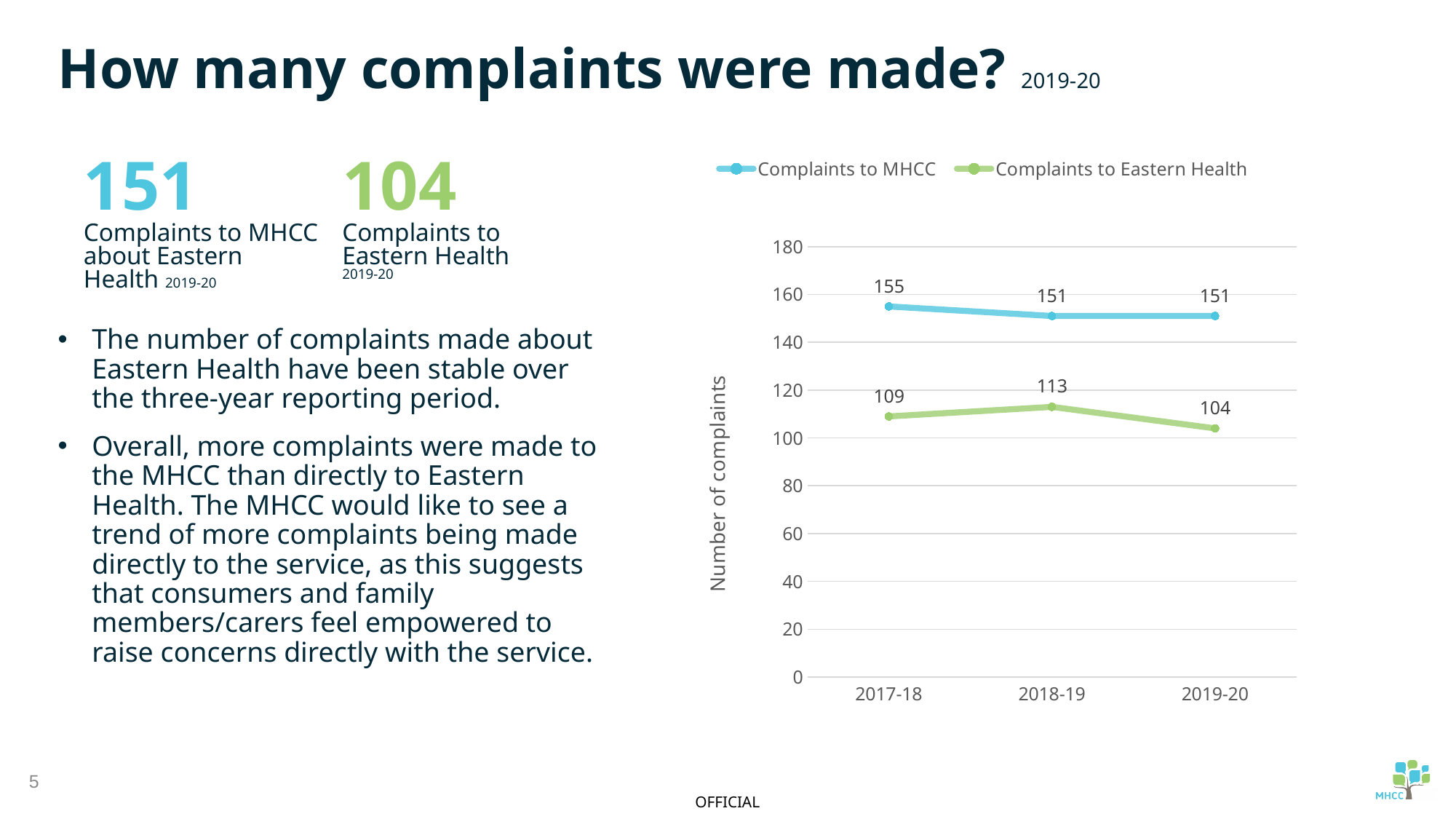
What was the number of complaints to MHCC in 2017-18? 155 What is the label on the y axis of the chart? Number of complaints What type of chart is shown on the slide? line chart What is the difference between complaints to MHCC and complaints to Eastern Health in 2019-20? 47 What was the number of complaints to Eastern Health in 2019-20? 104 What was the number of complaints to Eastern Health in 2018-19? 113 Did complaints to Eastern Health rise or fall from 2018-19 to 2019-20? fall How many series does the chart legend list? 2 How many periods are shown on the x axis of the chart? 3 Which series had more complaints in 2017-18, Complaints to MHCC or Complaints to Eastern Health? Complaints to MHCC In which period were complaints to Eastern Health lowest? 2019-20 In which period were complaints to Eastern Health highest? 2018-19